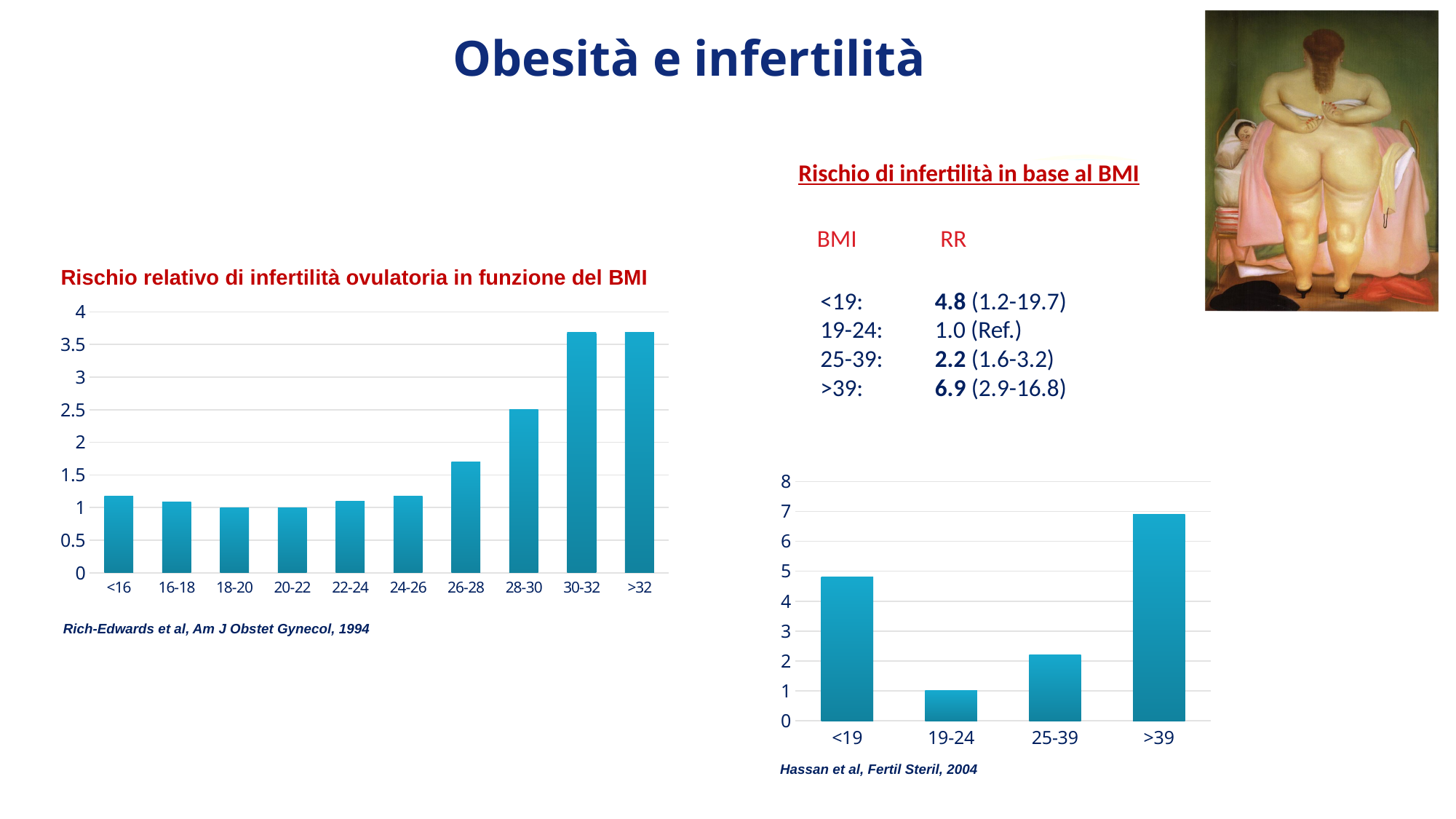
In the right chart (Hassan et al, Fertil Steril, 2004), what is the difference between the RR for BMI >39 and the RR for BMI <19? 2.1 In the right chart (Hassan et al, Fertil Steril, 2004), what is the RR value for BMI 25-39? 2.2 What type of chart is the left chart titled 'Rischio relativo di infertilità ovulatoria in funzione del BMI'? bar chart In the left chart, is the value for the 30-32 BMI category greater or less than 3.5? greater How many BMI categories are shown on the x axis of the left chart? 10 In the left chart, which is larger: the value for 28-30 or the value for 26-28? 28-30 In the right chart (Hassan et al, Fertil Steril, 2004), what is the RR value for BMI <19? 4.8 In the right chart (Hassan et al, Fertil Steril, 2004), which BMI category has the highest RR? >39 In the left chart, is the value for the 28-30 BMI category greater or less than 2? greater In the right chart (Hassan et al, Fertil Steril, 2004), which BMI category has the lowest RR? 19-24 In the left chart, is the value for the 26-28 BMI category greater or less than 1.5? greater In the left chart, do the values rise or fall from the 22-24 category to the 30-32 category? rise